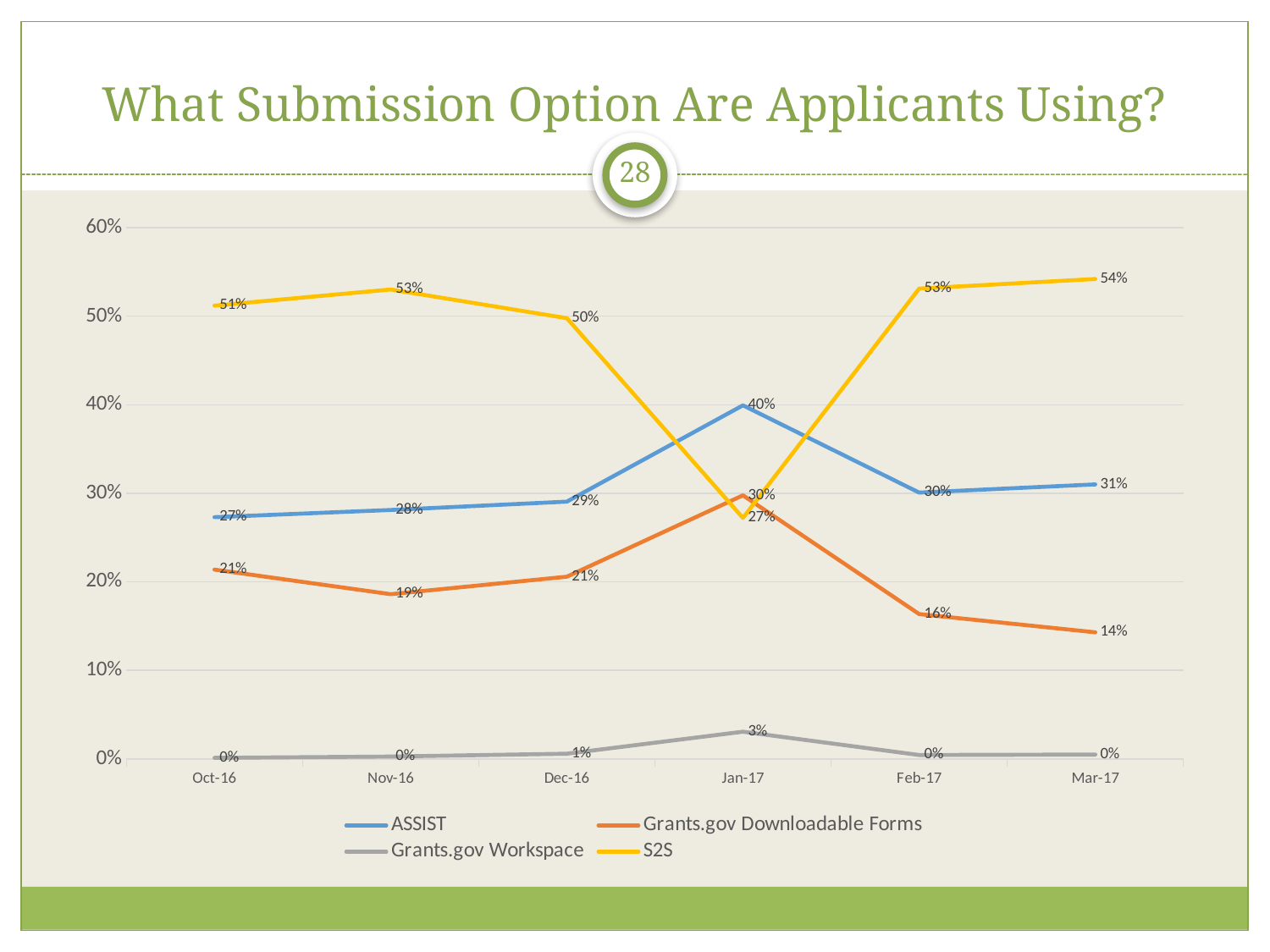
What is the value for Grants.gov Workspace in Jan-17? 3% How many series does the legend list? 4 How many months are shown on the x axis? 6 Which series has the higher value in Jan-17, ASSIST or S2S? ASSIST What is the value for ASSIST in Jan-17? 40% In which month is the ASSIST value lowest? Oct-16 What is the difference between the S2S value and the ASSIST value in Mar-17? 23% What type of chart is shown on the slide? line chart Does the Grants.gov Downloadable Forms value rise or fall from Jan-17 to Mar-17? fall In which month does S2S reach its highest value? Mar-17 What is the value for S2S in Jan-17? 27% What is the value for Grants.gov Downloadable Forms in Mar-17? 14%